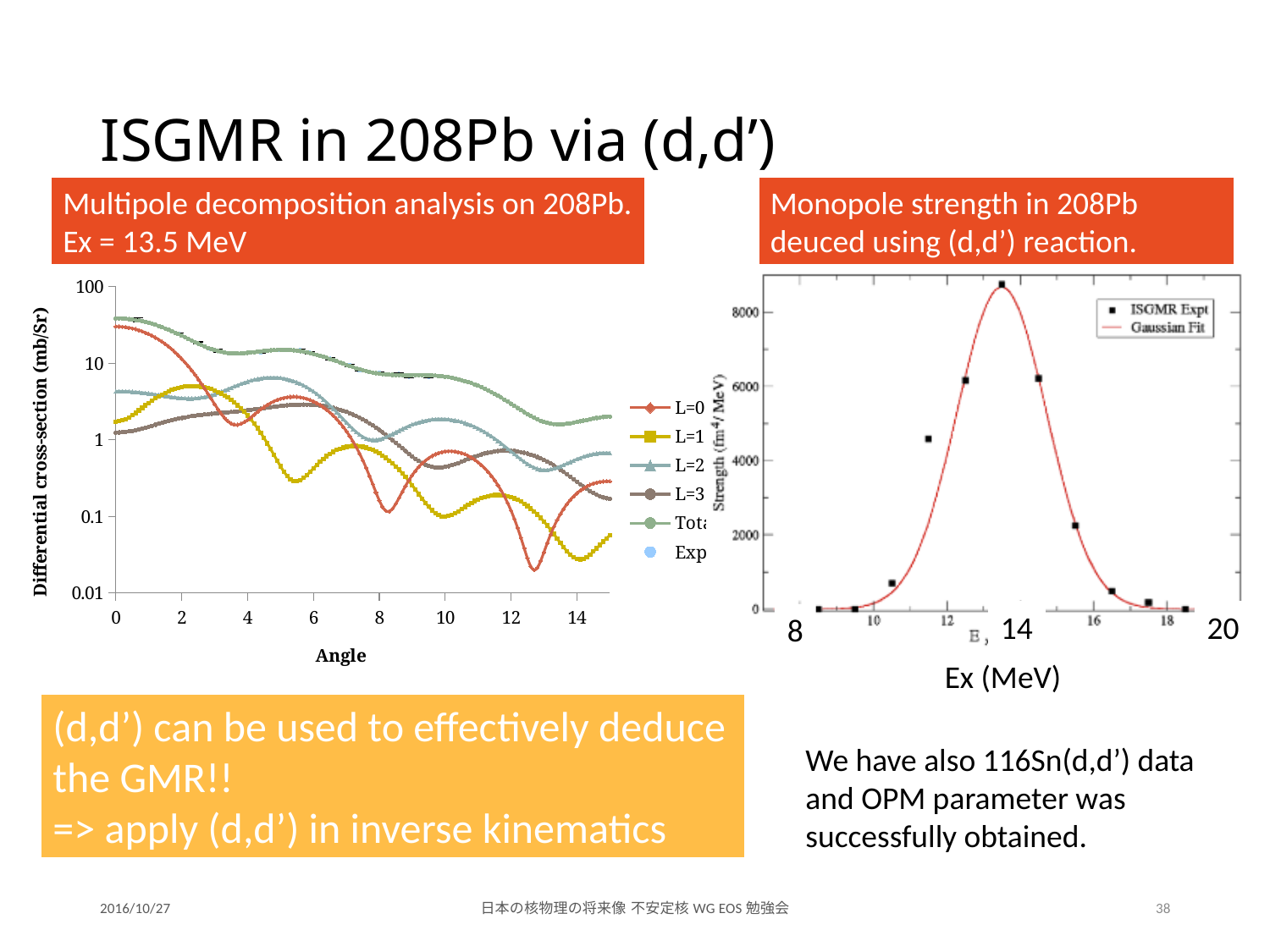
In the left chart, is the value of the L=0 series at angle 0 greater or less than 10? greater In the left chart, at angle 0, which is larger: L=0 or L=1? L=0 In the left chart, is the minimum of the L=0 series near angle 12.6 greater or less than 0.1? less What is the y-axis label of the left chart? Differential cross-section (mb/Sr) In the right chart (Monopole strength in 208Pb), is the ISGMR Expt value at Ex = 10 MeV greater or less than 2000? less In the left chart, does the Total series overall rise or fall as the angle increases from 0 to 14? fall What kind of chart is the left chart showing differential cross-section versus angle? line chart How many series does the legend of the left chart list? 6 How many series does the legend of the right chart (Monopole strength in 208Pb) list? 2